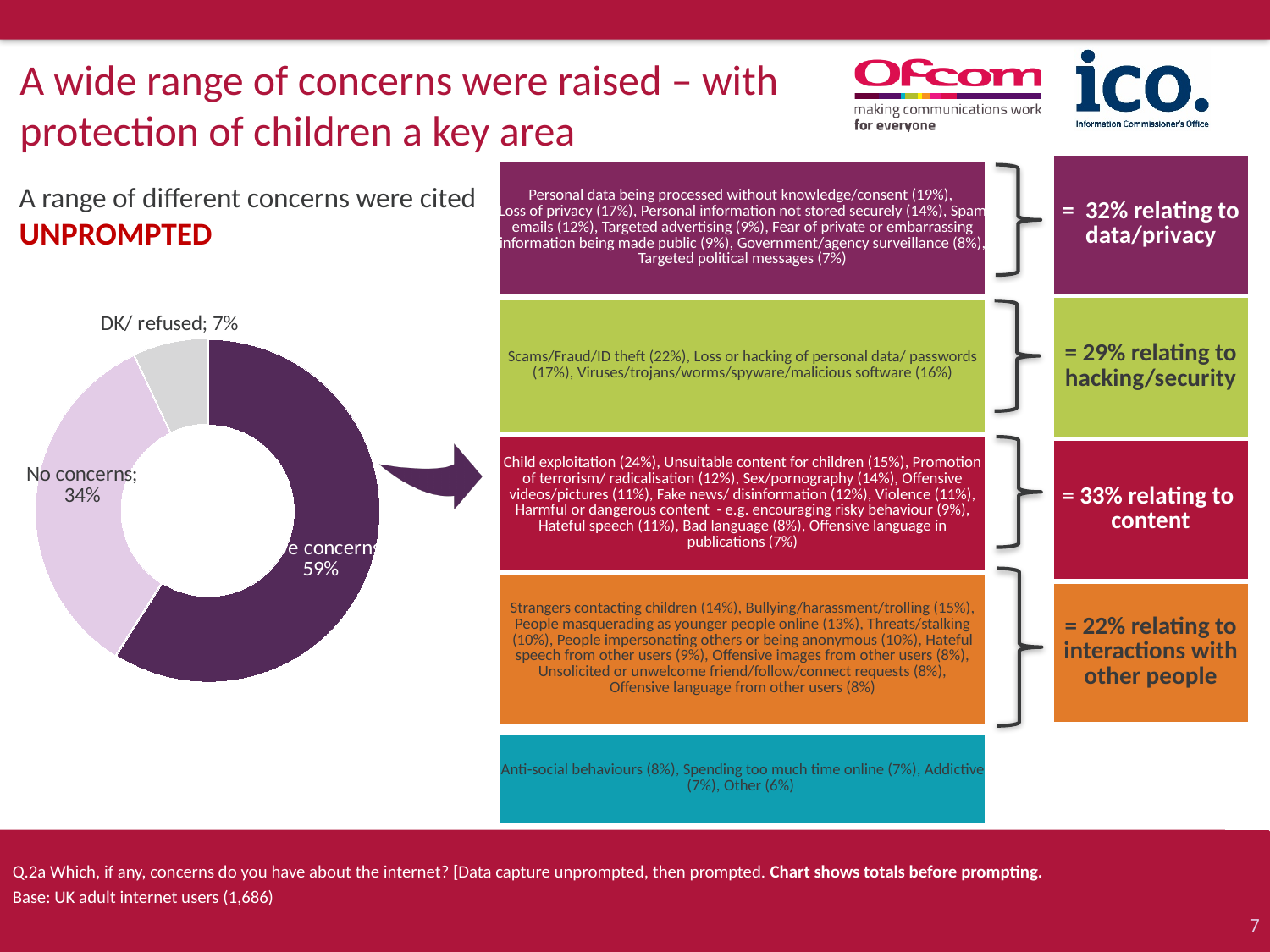
What is the difference in percentage points between the largest slice (59%) and "No concerns" in the pie chart? 25 What colour is the "DK/ refused" slice in the pie chart? Grey Which slice of the pie chart is the smallest? DK/ refused What percentage does the pie chart show for "DK/ refused"? 7% What is the difference in percentage points between "No concerns" and "DK/ refused" in the pie chart? 27 What percentage is shown on the largest slice of the pie chart? 59% What percentage does the pie chart show for "No concerns"? 34% What kind of chart is shown on the left of the slide? Doughnut chart How many slices does the pie chart have? 3 What colour is the "No concerns" slice in the pie chart? Light pink In the pie chart, which is larger: "No concerns" or "DK/ refused"? No concerns